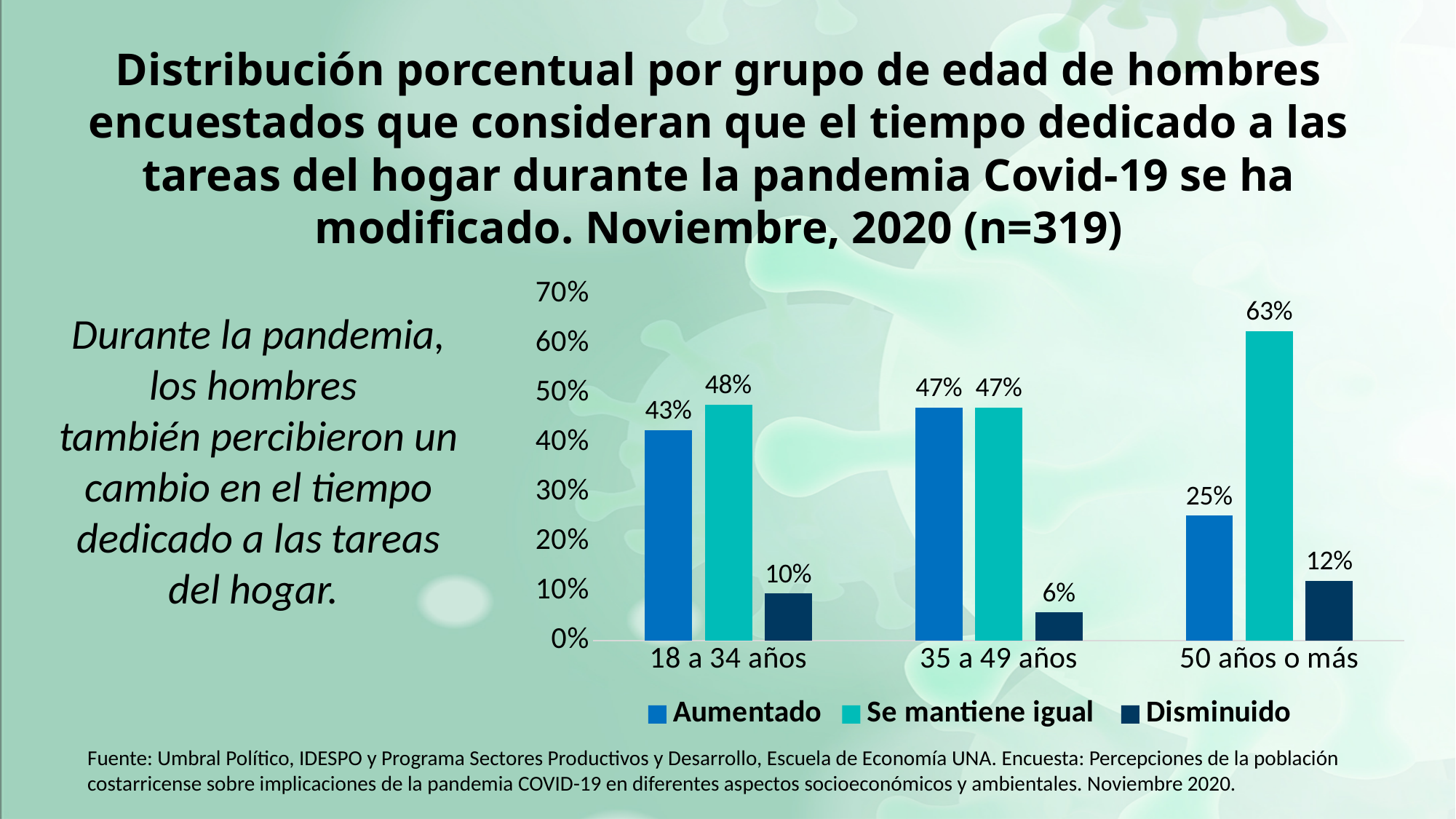
Which series is shown in dark navy blue in the legend? Disminuido What is the difference between "Se mantiene igual" and "Aumentado" in the "50 años o más" group? 38% Which age group has the highest value for "Se mantiene igual"? 50 años o más Do the values for "Aumentado" rise or fall from the "35 a 49 años" group to the "50 años o más" group? Fall What is the value for "Aumentado" in the "18 a 34 años" group? 43% Which age group has the lowest value for "Aumentado"? 50 años o más What is the value for "Se mantiene igual" in the "50 años o más" group? 63% How many series does the legend list? 3 How many age groups are shown on the x axis? 3 What kind of chart is shown on the slide? Bar chart Which is larger in the "18 a 34 años" group: "Aumentado" or "Se mantiene igual"? Se mantiene igual What is the value for "Disminuido" in the "35 a 49 años" group? 6%